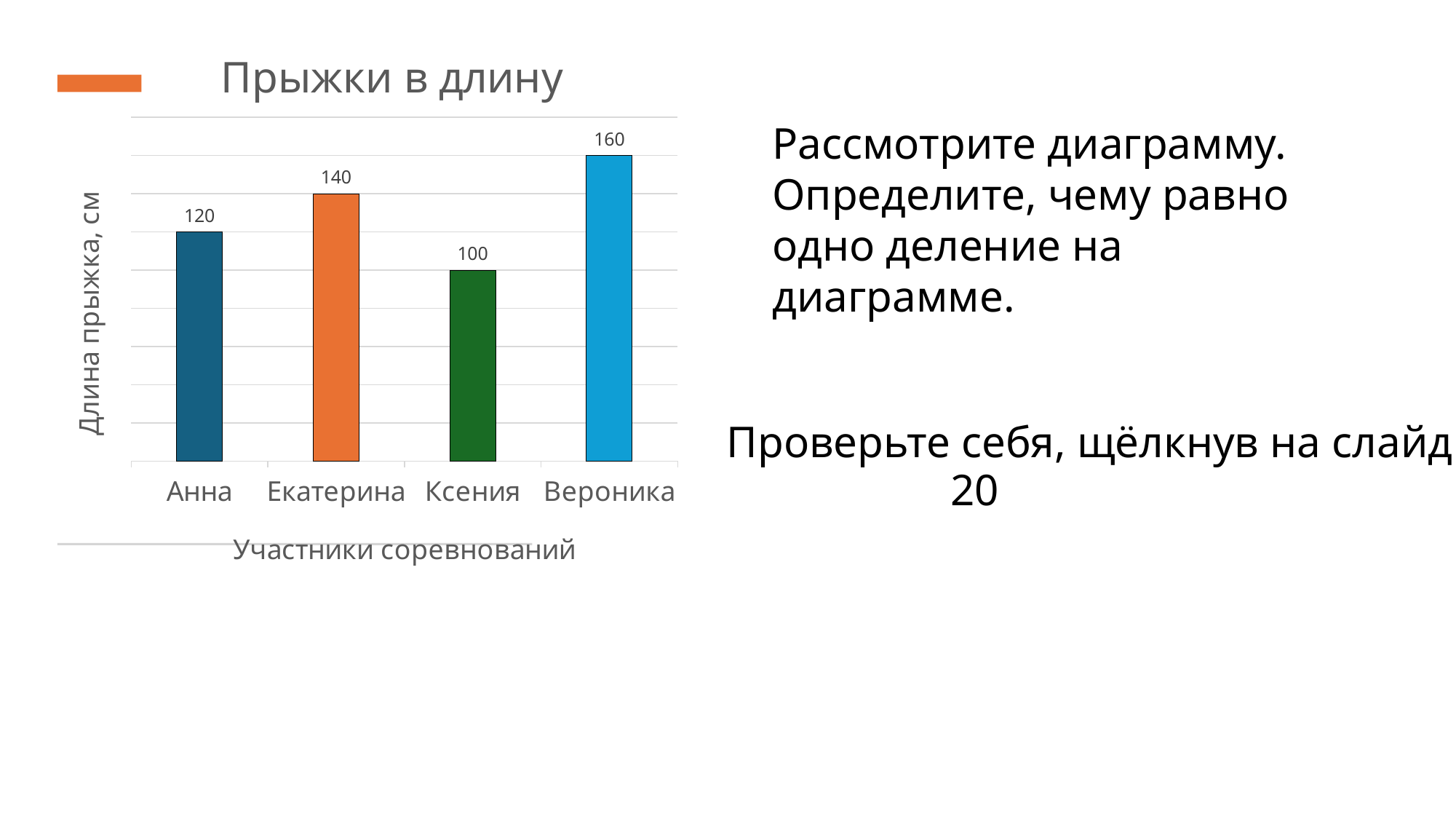
What is the jump length for Анна? 120 What is the jump length for Ксения? 100 What is the difference between Вероника's and Анна's jump lengths? 40 Which participant has the longest jump? Вероника What is the jump length for Вероника? 160 Which participant has the shortest jump? Ксения Who jumped farther, Анна or Екатерина? Екатерина What is the difference between Екатерина's and Ксения's jump lengths? 40 What kind of chart is shown on the slide? Bar chart What is the jump length for Екатерина? 140 How many participants are shown on the chart? 4 What is the title of the chart? Прыжки в длину